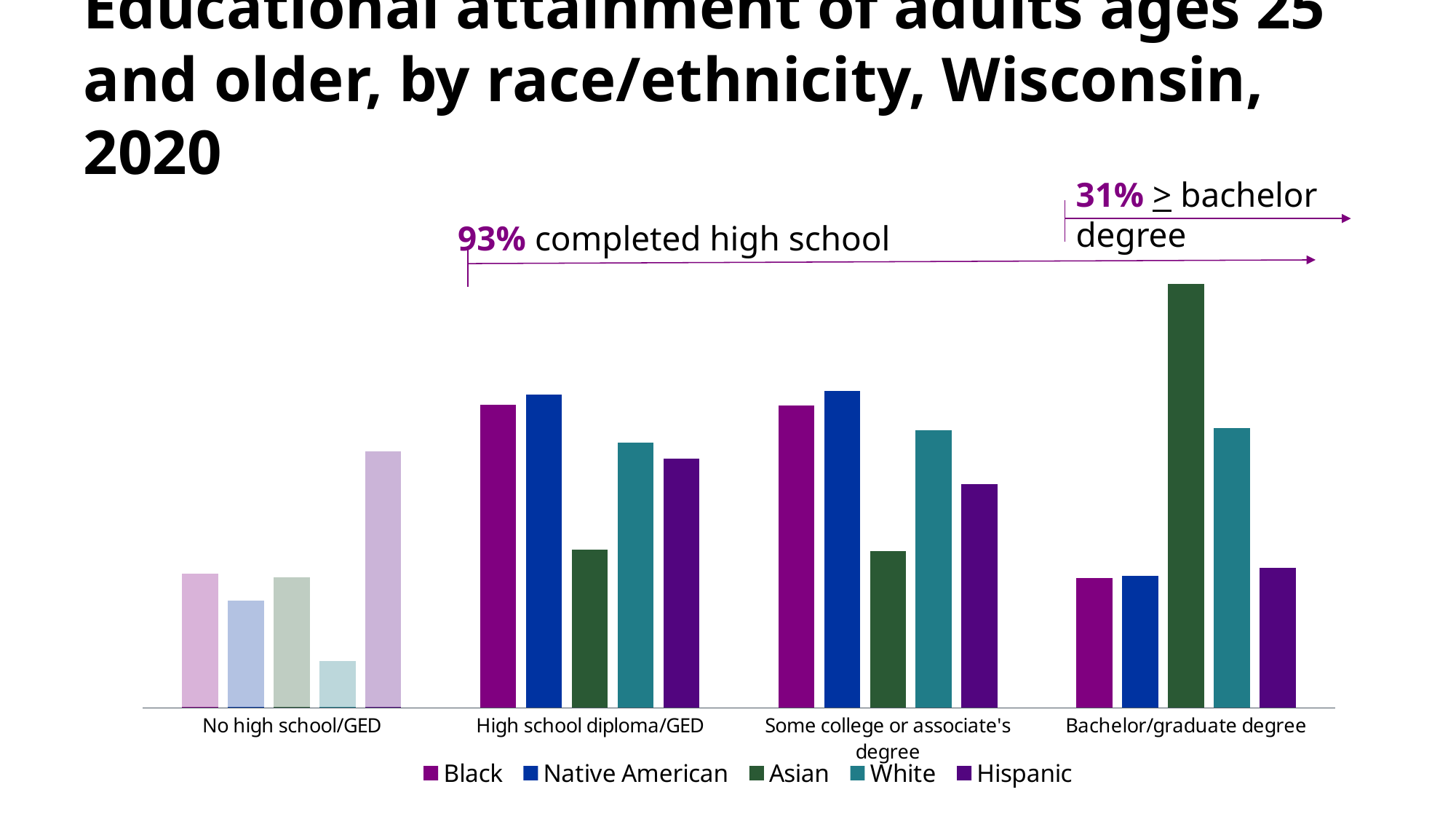
Which race/ethnicity has the lowest bar in the No high school/GED category? White What kind of chart is shown on the slide? Bar chart In the Bachelor/graduate degree category, is the bar for Asian or White taller? Asian According to the annotation on the chart, what percentage have a bachelor degree or higher? 31% Which race/ethnicity has the highest bar in the No high school/GED category? Hispanic How many series does the legend list? 5 How many education categories are shown along the x axis? 4 In the Some college or associate's degree category, is the bar for White or Hispanic taller? White According to the annotation on the chart, what percentage completed high school? 93% Which race/ethnicity has the lowest bar in the Some college or associate's degree category? Asian Which race/ethnicity has the highest bar in the Bachelor/graduate degree category? Asian Which race/ethnicity has the lowest bar in the High school diploma/GED category? Asian